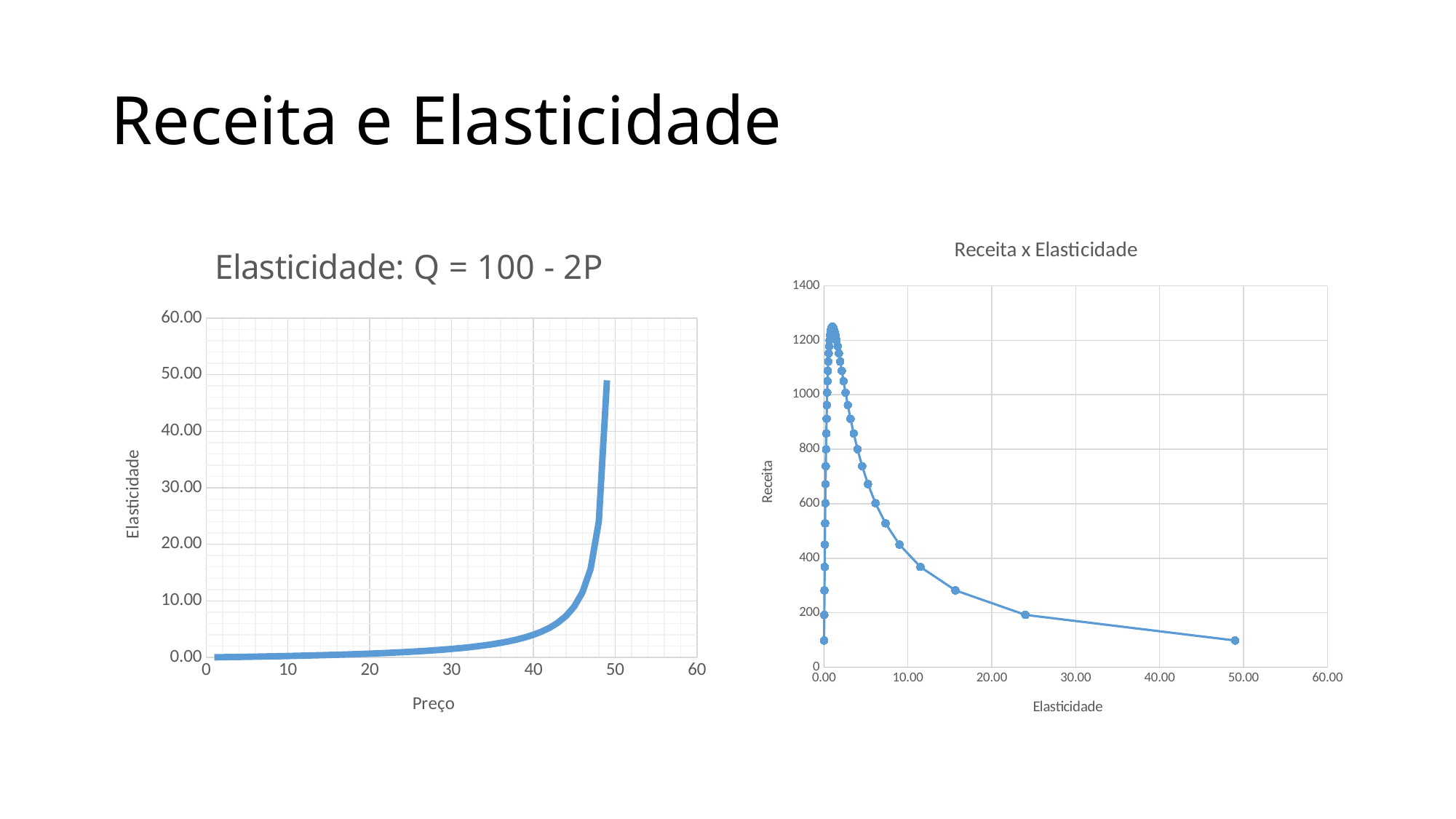
In the chart on the left, is the highest value of Elasticidade reached by the curve greater or less than 40.00? greater In the chart on the left, what kind of chart is it? line chart What is the title of the chart on the right? Receita x Elasticidade In the chart on the right, what is the label of the y axis? Receita In the chart on the right, what is the highest tick value shown on the Receita axis? 1400 In the chart on the right, is the Receita of the point at Elasticidade near 50.00 greater or less than 200? less In the chart on the left, does Elasticidade rise or fall as Preço increases? rise In the chart on the left, what is the label of the x axis? Preço In the chart on the left, is the value of Elasticidade at Preço 40 greater or less than 10.00? less What is the title of the chart on the left? Elasticidade: Q = 100 - 2P In the chart on the right, after the peak, does Receita rise or fall as Elasticidade increases? fall